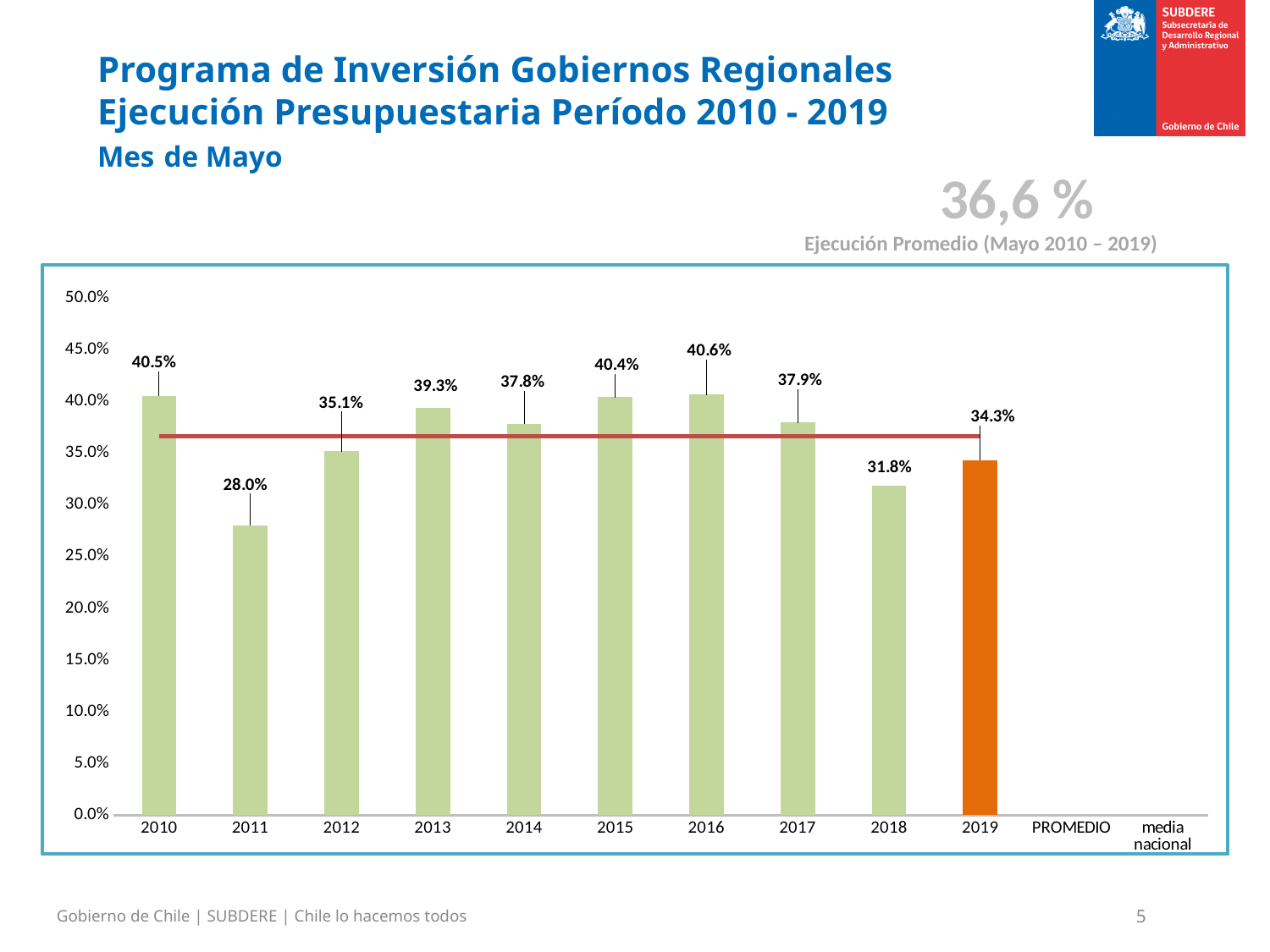
Do the values rise or fall from 2016 to 2018? fall Which year has the highest value? 2016 What is the value for 2019? 34.3% How many bars are plotted in the chart? 10 Which year has the lowest value? 2011 Is the value for 2018 greater or less than 35.0%? less What kind of chart is shown on the slide? bar chart What is the difference between the values for 2019 and 2018? 2.5% What is the value for 2014? 37.8% What is the difference between the values for 2010 and 2011? 12.5% Which is larger, the value for 2013 or the value for 2017? 2013 What is the value for 2010? 40.5%